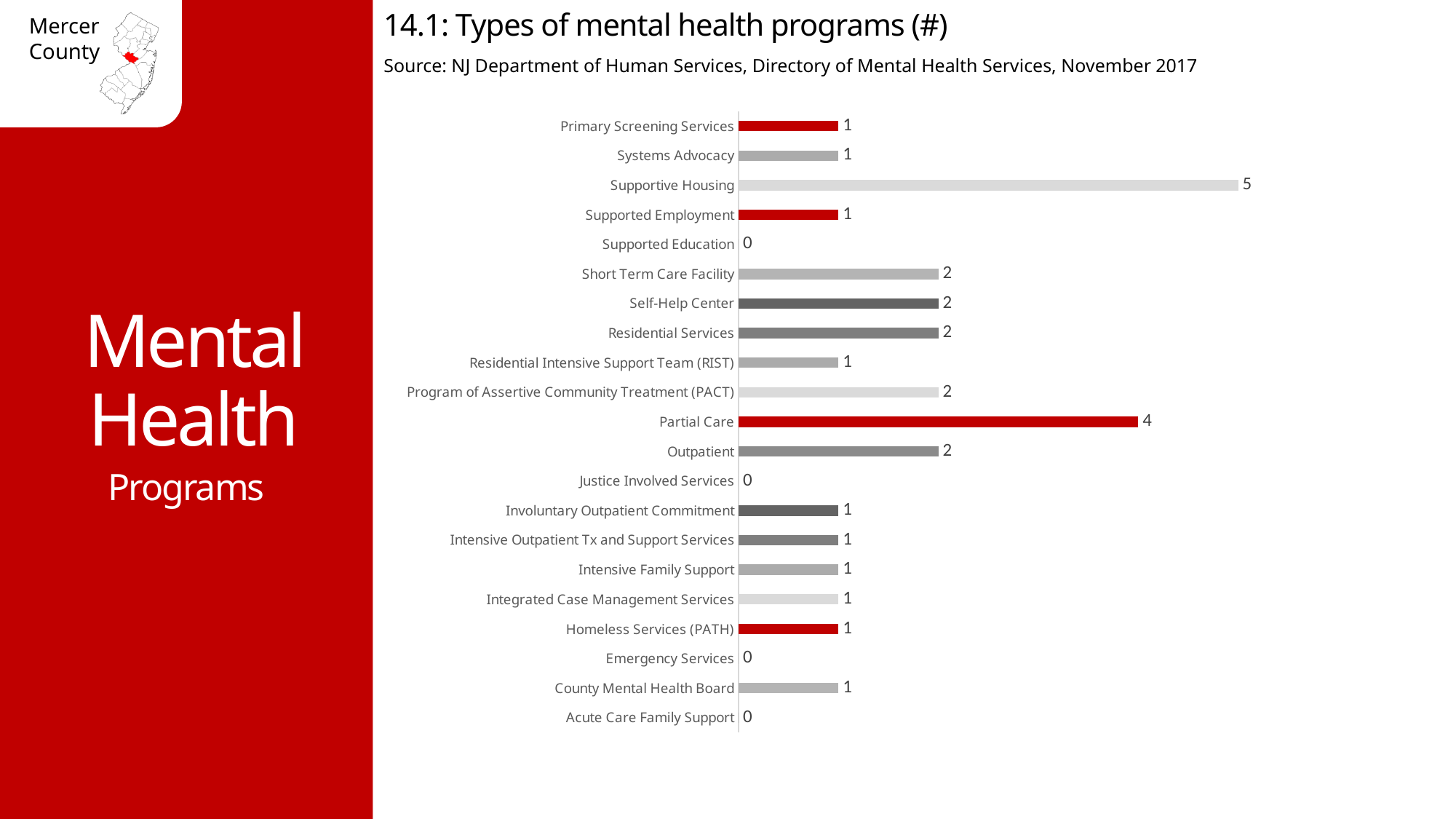
What is the value for Outpatient? 2 What is the difference between the values for Supportive Housing and Partial Care? 1 What is the value for Partial Care? 4 What is the difference between the values for Partial Care and Outpatient? 2 What is the title of the chart? 14.1: Types of mental health programs (#) What type of chart is shown on the slide? bar chart Which category has the highest value? Supportive Housing Which is larger, the value for Self-Help Center or the value for Systems Advocacy? Self-Help Center How many categories are plotted on the chart? 21 How many program types does the Supportive Housing bar show? 5 What is the value for Supported Education? 0 What is the value for Homeless Services (PATH)? 1